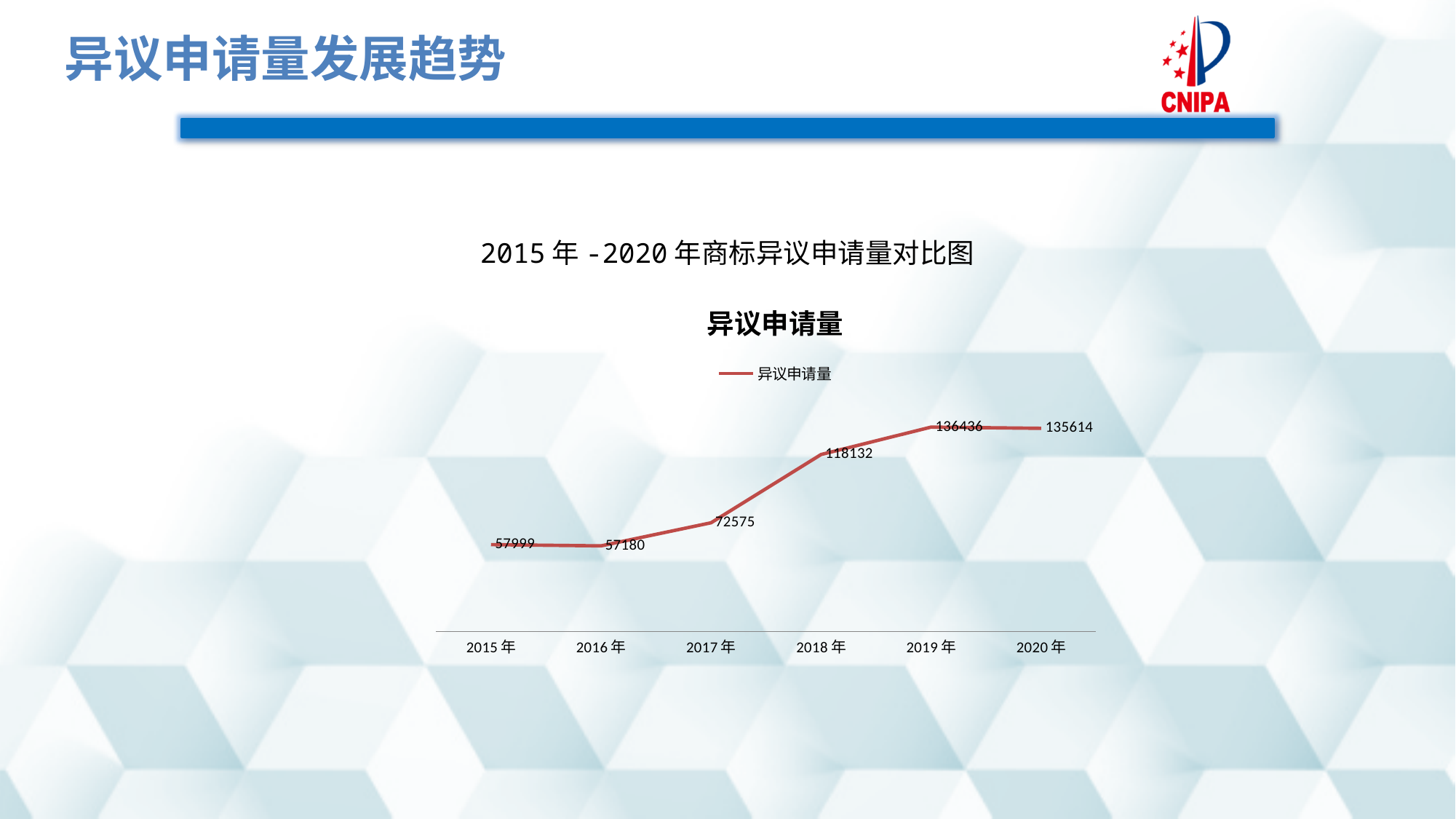
Which year has the highest value in the 异议申请量 chart? 2019年 What kind of chart is the 异议申请量 chart? line chart What is the difference between the values for 2017年 and 2016年 in the 异议申请量 chart? 15395 Do the values in the 异议申请量 chart generally rise or fall from 2015年 to 2019年? rise How many series does the legend of the 异议申请量 chart list? 1 How many years are plotted on the x axis of the 异议申请量 chart? 6 What is the difference between the values for 2019年 and 2018年 in the 异议申请量 chart? 18304 What is the value for 2020年 in the 异议申请量 chart? 135614 What is the value for 2015年 in the 异议申请量 chart? 57999 Which year has the lowest value in the 异议申请量 chart? 2016年 Which is larger in the 异议申请量 chart, the value for 2017年 or the value for 2018年? 2018年 What is the value for 2018年 in the 异议申请量 chart? 118132